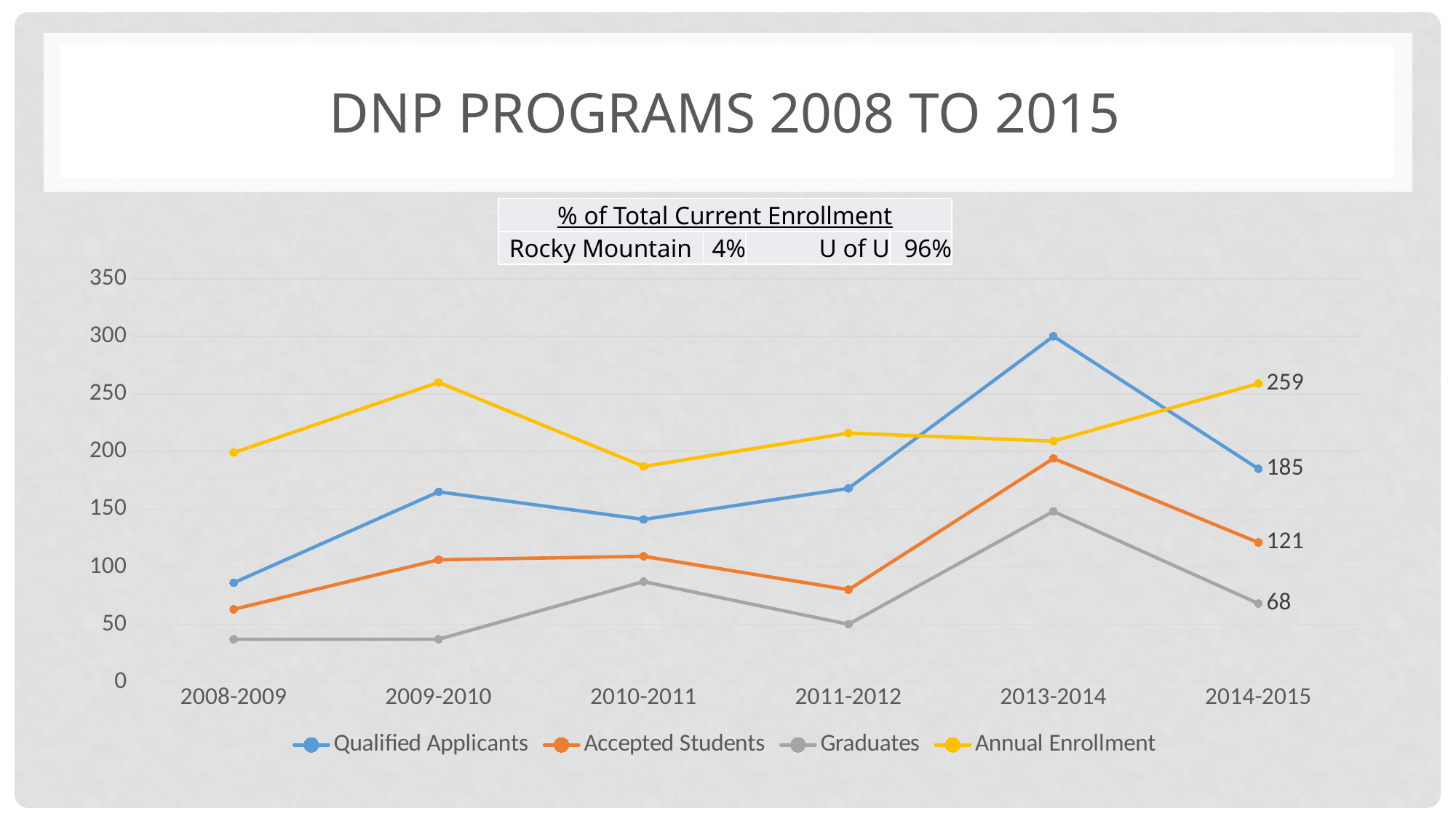
Which series has the lowest value in 2008-2009? Graduates Which series has the highest value in 2014-2015? Annual Enrollment What is the value for Qualified Applicants in 2014-2015? 185 What is the difference between Qualified Applicants and Accepted Students in 2014-2015? 64 What is the value for Accepted Students in 2014-2015? 121 What is the value for Graduates in 2014-2015? 68 How many series does the legend list? 4 How many academic-year categories are shown on the x axis? 6 What is the value for Annual Enrollment in 2014-2015? 259 Is the value for Qualified Applicants in 2013-2014 greater or less than 250? greater What type of chart is shown on the slide? line chart Which is larger in 2013-2014, Qualified Applicants or Annual Enrollment? Qualified Applicants